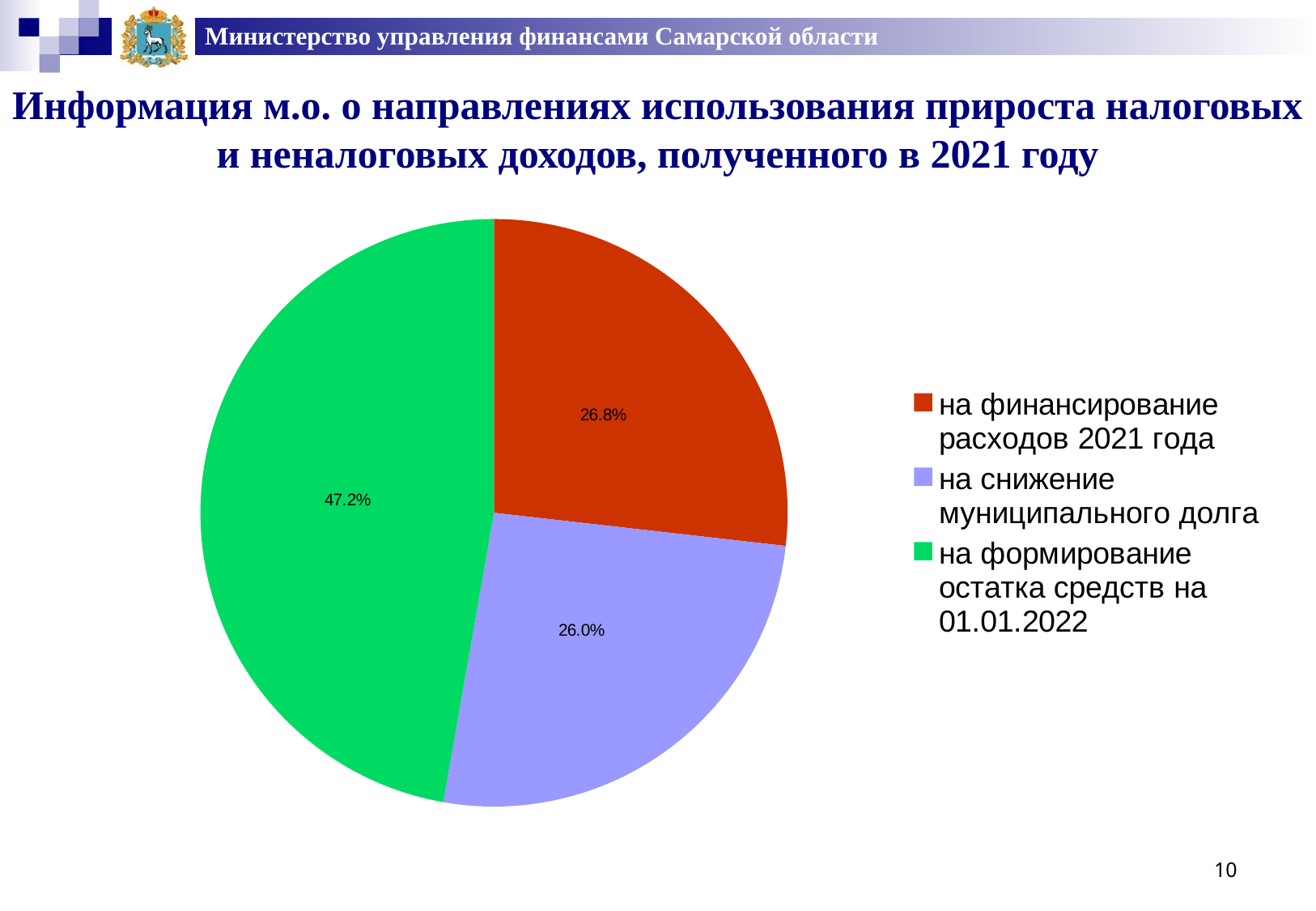
How many entries does the legend list? 3 Which category has the smallest slice of the pie? на снижение муниципального долга What colour is the slice for "на финансирование расходов 2021 года"? red Which category has the largest slice of the pie? на формирование остатка средств на 01.01.2022 What kind of chart is shown on the slide? pie chart What share of the pie is labelled for "на финансирование расходов 2021 года"? 26.8% What is the difference in percentage points between the slice for "на формирование остатка средств на 01.01.2022" and the slice for "на финансирование расходов 2021 года"? 20.4 How many slices does the pie chart have? 3 What share of the pie is labelled for "на снижение муниципального долга"? 26.0% Which is larger: the slice for "на финансирование расходов 2021 года" or the slice for "на снижение муниципального долга"? на финансирование расходов 2021 года What share of the pie is labelled for "на формирование остатка средств на 01.01.2022"? 47.2% What colour is the slice for "на формирование остатка средств на 01.01.2022"? green